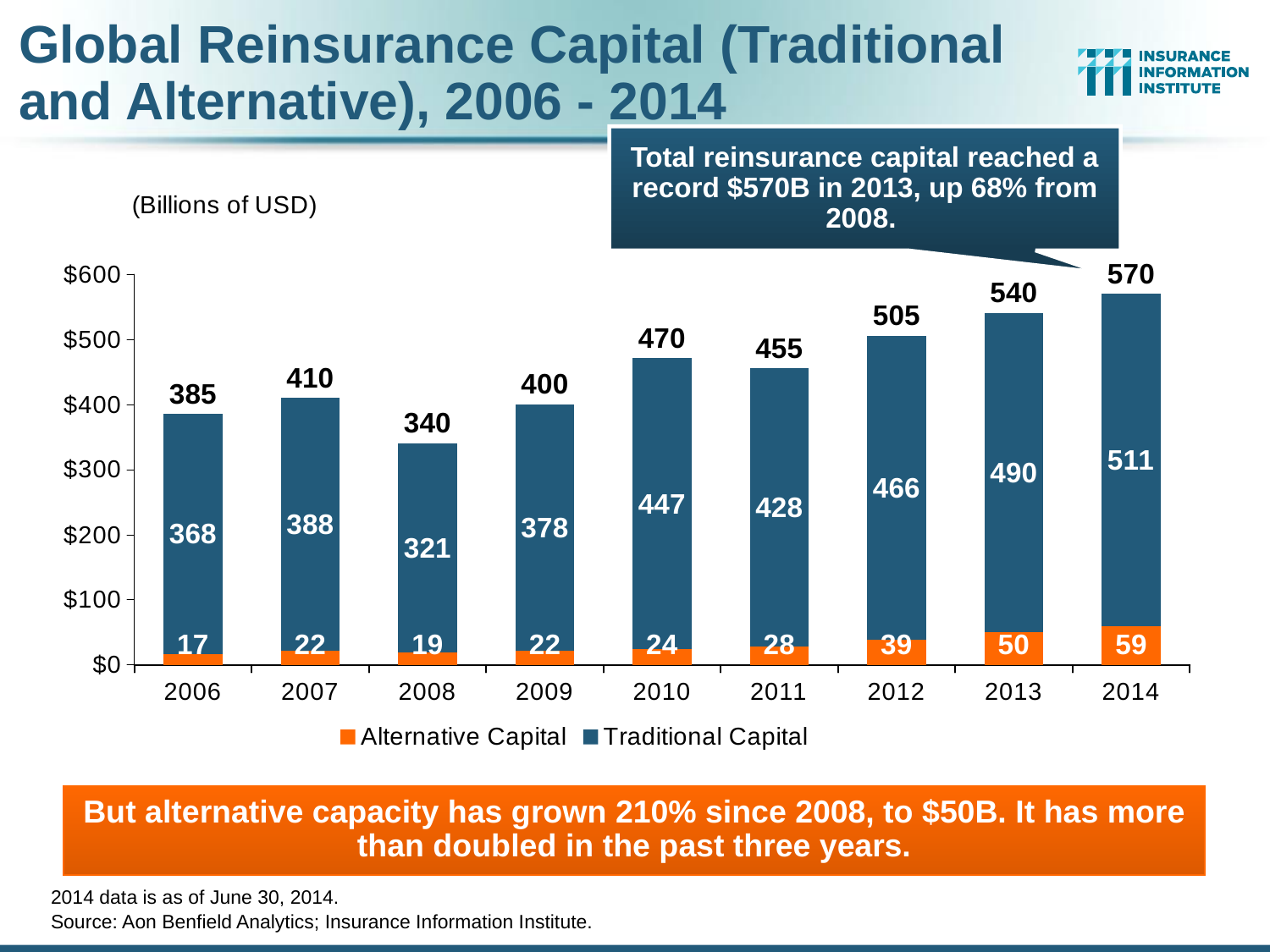
Which year has the lowest Alternative Capital value? 2006 Which colour represents Alternative Capital in the chart? Orange What is the Traditional Capital value for 2010? 447 Does the total reinsurance capital rise or fall from 2011 to 2014? Rise What is the difference between the Traditional Capital values for 2014 and 2013? 21 What is the Alternative Capital value for 2013? 50 How many series does the legend list? 2 What kind of chart is shown on the slide? Stacked bar chart How many years are shown on the x axis? 9 What is the total reinsurance capital shown for 2008? 340 Which year has the highest total reinsurance capital? 2014 Which is larger, the Alternative Capital value for 2012 or for 2011? 2012